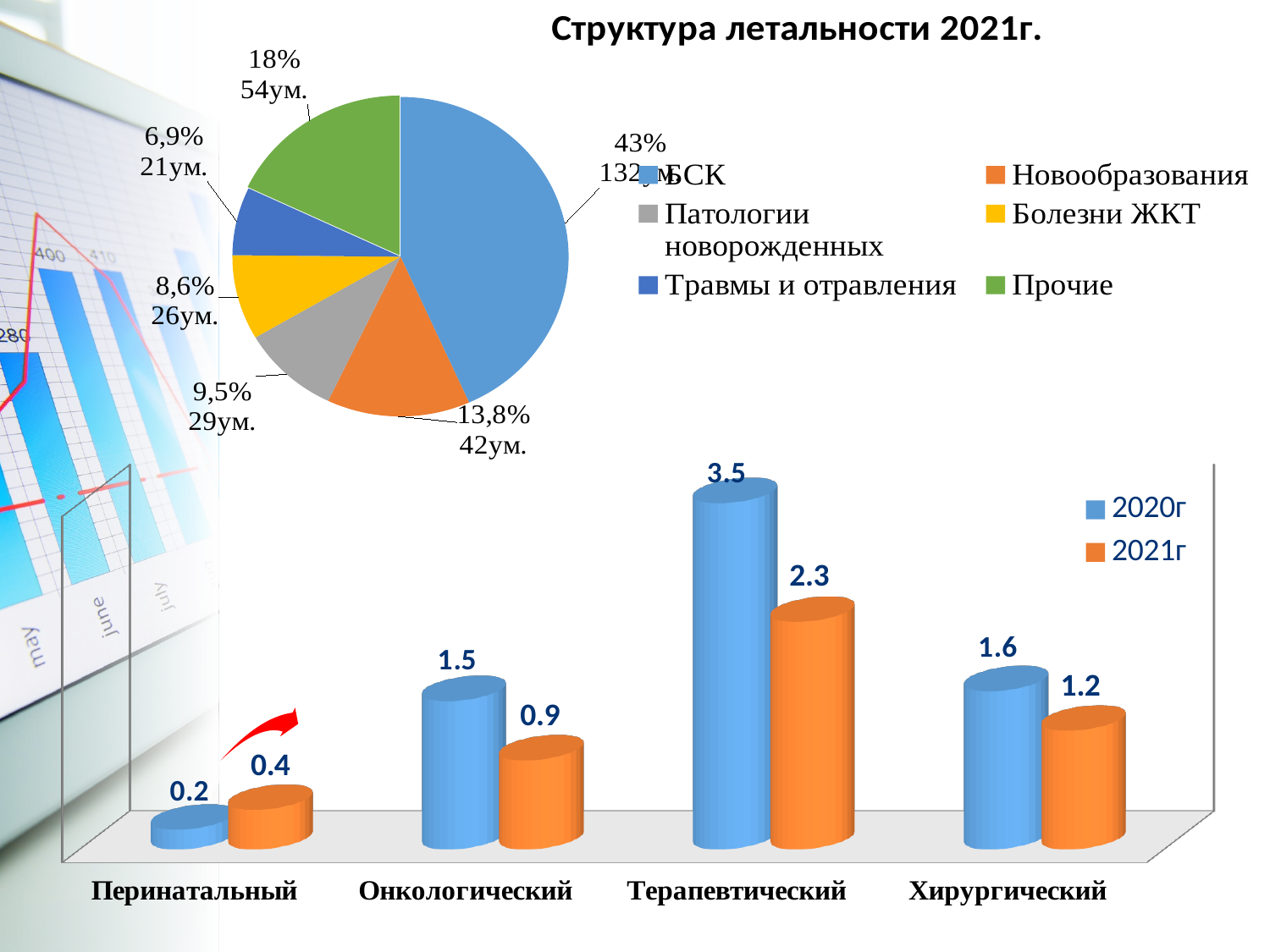
In the pie chart 'Структура летальности 2021г.', what colour is the Болезни ЖКТ slice? Yellow In the pie chart 'Структура летальности 2021г.', what percentage is shown for Новообразования? 13,8% In the bar chart at the bottom of the slide, what is the value for Терапевтический in 2020г? 3.5 In the bar chart at the bottom of the slide, what is the value for Перинатальный in 2021г? 0.4 In the bar chart at the bottom of the slide, which category has the highest 2021г value? Терапевтический In the bar chart at the bottom of the slide, how many series does the legend list? 2 In the pie chart 'Структура летальности 2021г.', how many deaths are shown for Прочие? 54ум. In the bar chart at the bottom of the slide, which is larger for Хирургический: the 2020г value or the 2021г value? 2020г In the pie chart 'Структура летальности 2021г.', which category has the smallest share? Травмы и отравления In the pie chart 'Структура летальности 2021г.', what share does БСК have? 43% In the bar chart at the bottom of the slide, what is the difference between the 2020г and 2021г values for Онкологический? 0.6 In the pie chart 'Структура летальности 2021г.', how many categories does the legend list? 6